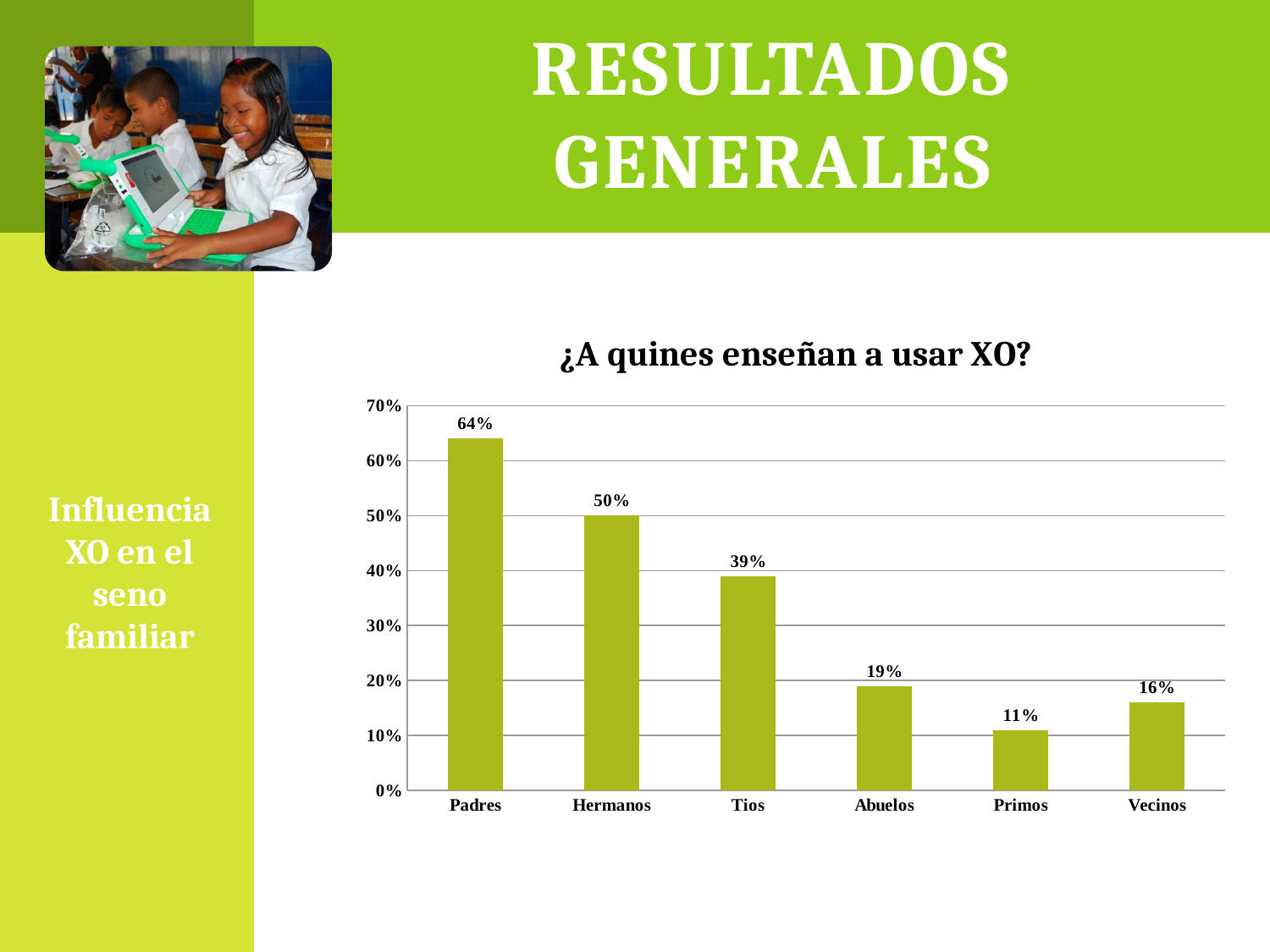
Which is larger, the value for Hermanos or the value for Tios? Hermanos What is the value for Vecinos? 16% What kind of chart is shown on the slide? bar chart What is the title of the chart? ¿A quines enseñan a usar XO? What is the value for Padres? 64% How many categories are shown on the x axis? 6 Which category has the highest value? Padres What is the value for Abuelos? 19% Is the value for Tios greater or less than 40%? less Which category has the lowest value? Primos What is the difference between the values for Padres and Hermanos? 14% What is the difference between the values for Tios and Abuelos? 20%